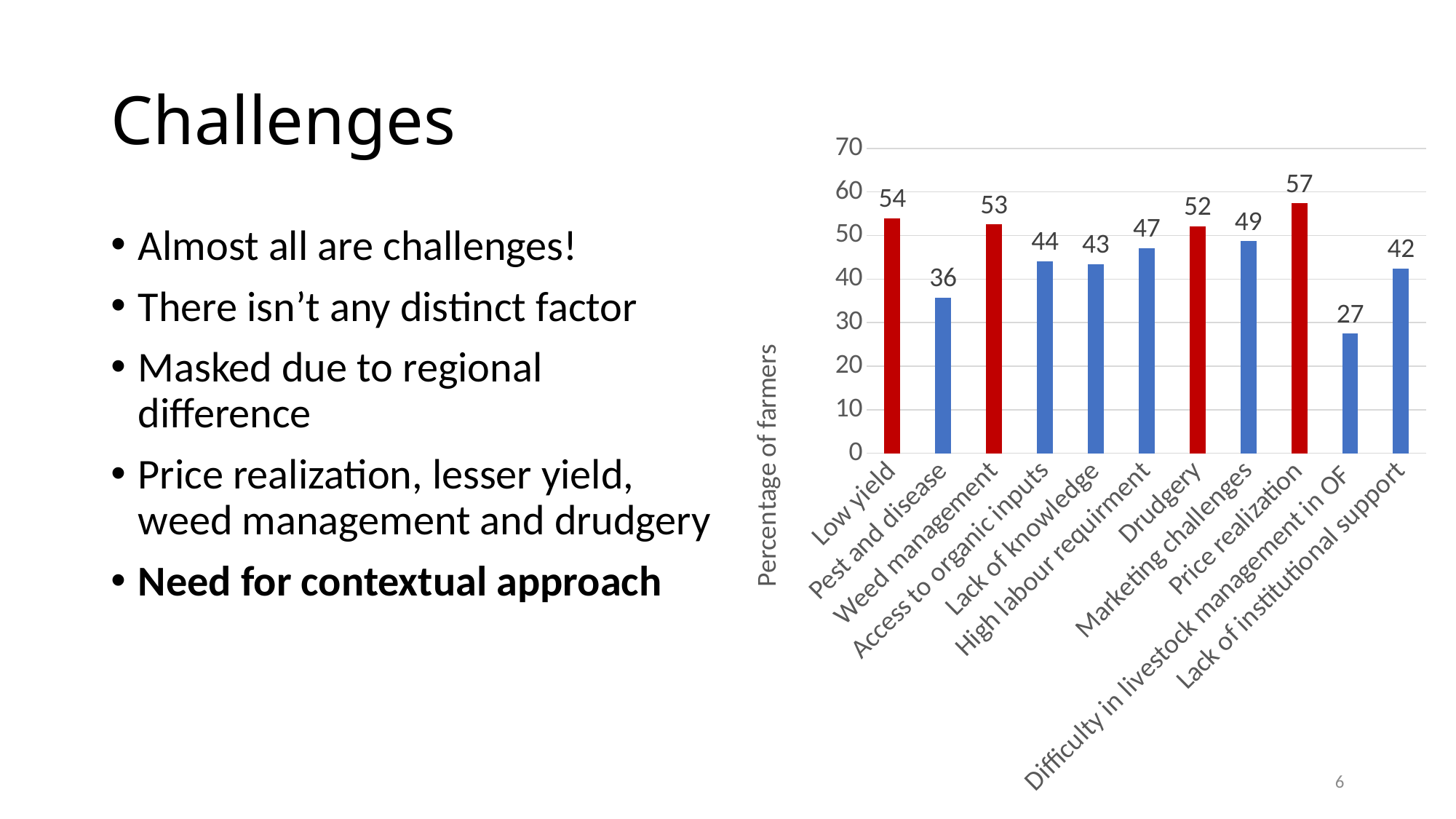
How many bars are coloured red? 4 What kind of chart is shown on the slide? Bar chart What is the value for High labour requirment? 47 Which category has the highest value? Price realization How many categories are shown on the x axis? 11 Which is larger, the value for Drudgery or the value for Marketing challenges? Drudgery What is the label of the vertical axis? Percentage of farmers Is the value for Lack of institutional support greater or less than 40? greater What is the value for Difficulty in livestock management in OF? 27 Which category has the lowest value? Difficulty in livestock management in OF What is the difference between the values for Price realization and Pest and disease? 21 What is the value for Low yield? 54